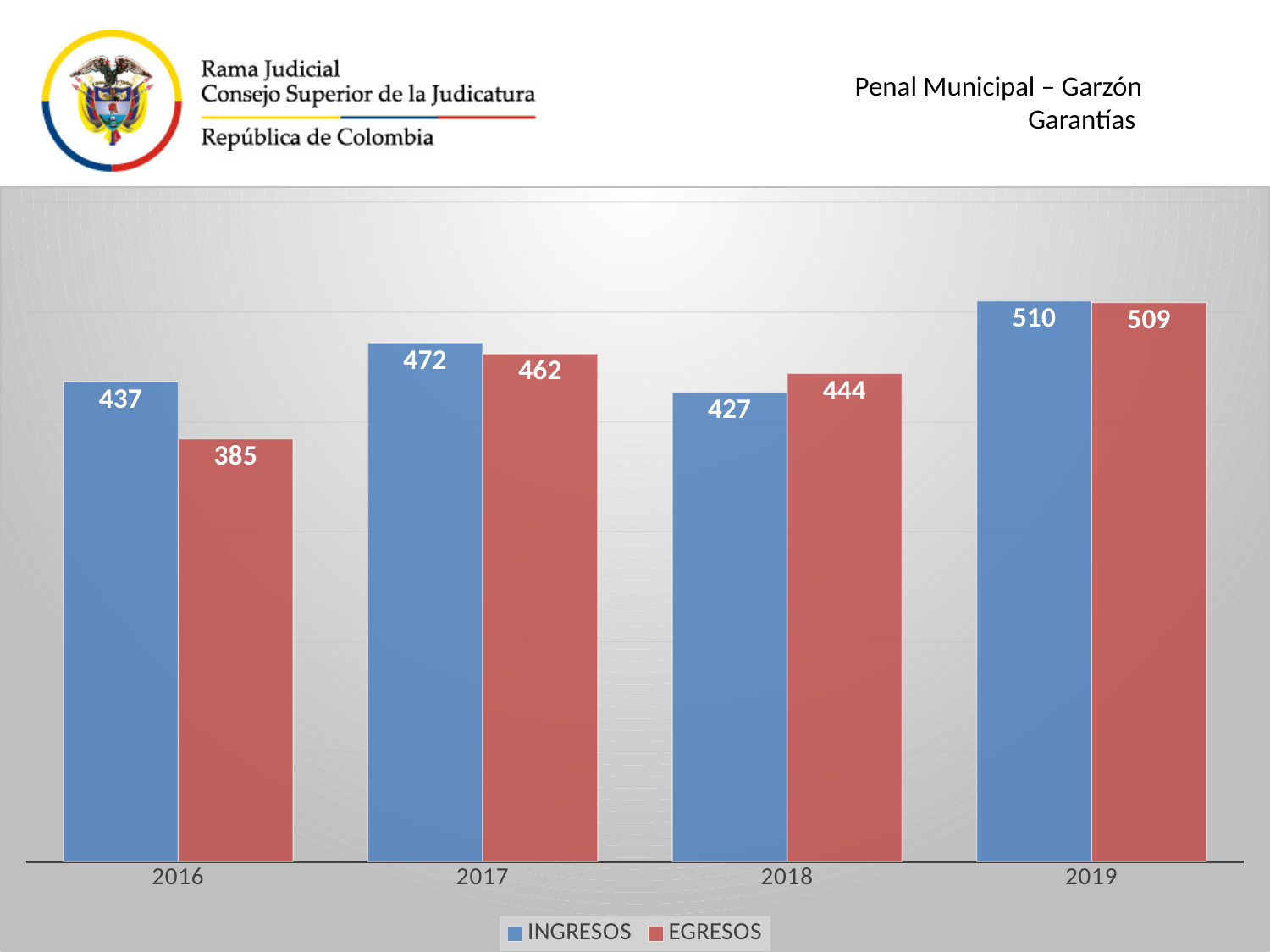
What is the INGRESOS value for 2016? 437 What is the EGRESOS value for 2018? 444 How many years are shown on the x axis? 4 In 2018, which is larger, INGRESOS or EGRESOS? EGRESOS What kind of chart is shown on the slide? Bar chart Which series is shown in red in the legend? EGRESOS How many series does the legend list? 2 What is the EGRESOS value for 2017? 462 What is the difference between INGRESOS and EGRESOS in 2016? 52 What is the difference between INGRESOS in 2019 and INGRESOS in 2018? 83 Which year has the highest INGRESOS value? 2019 Which year has the lowest EGRESOS value? 2016